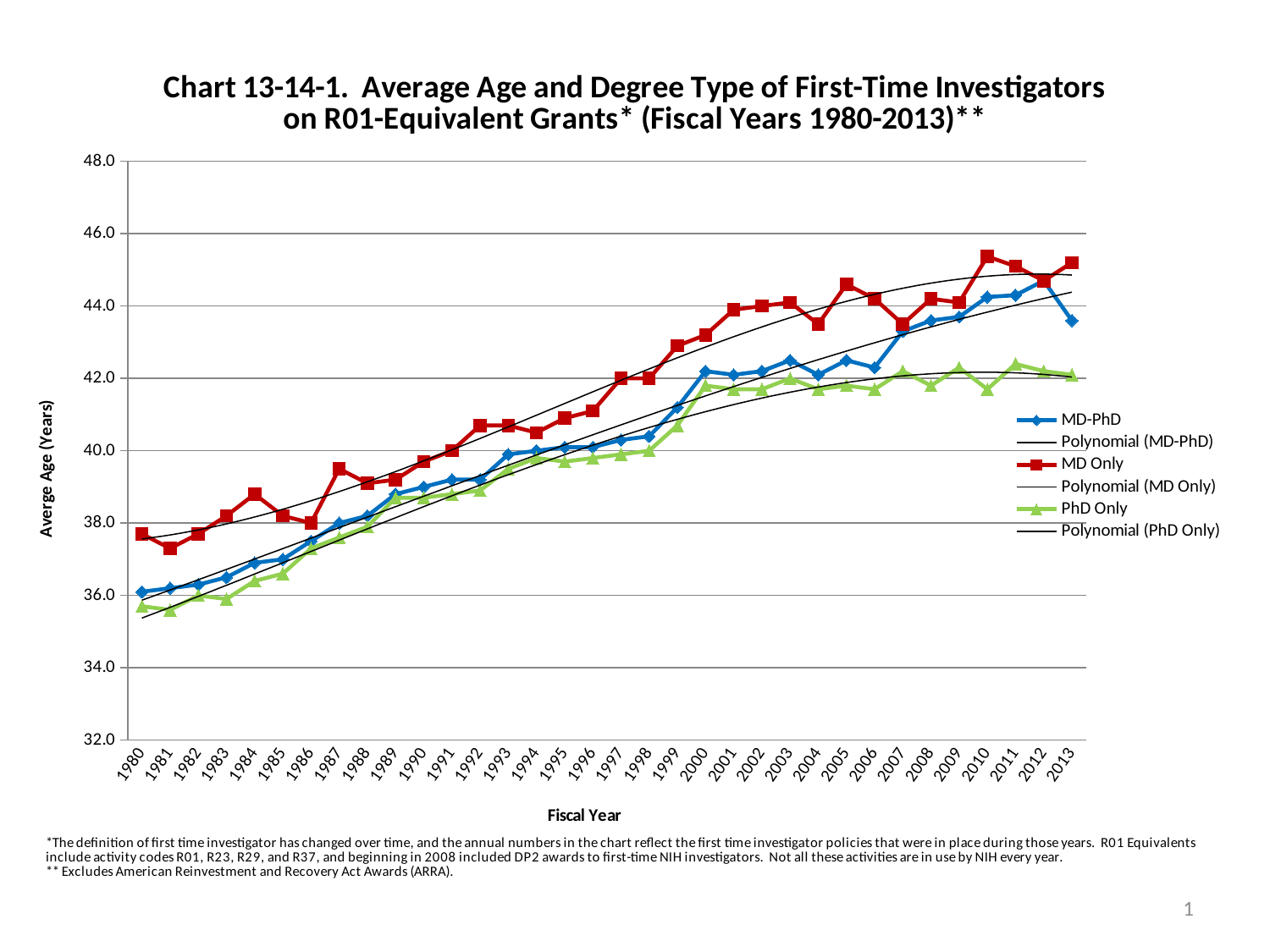
Does the average age for PhD Only investigators generally rise or fall across the fiscal years shown? Rise What is the title of the x axis? Fiscal Year What kind of chart is shown on the slide? Line chart How many entries does the legend list? 6 Is the PhD Only value for 1990 greater or less than 40.0? less In 1980, which series has the larger value, MD Only or MD-PhD? MD Only Is the MD Only value for 2010 greater or less than 44.0? greater How many fiscal years are plotted along the x axis? 34 Does the average age for MD Only investigators generally rise or fall from 1980 to 2013? Rise Is the MD-PhD value for 1980 greater or less than 38.0? less In 2013, which series has the larger value, MD Only or PhD Only? MD Only